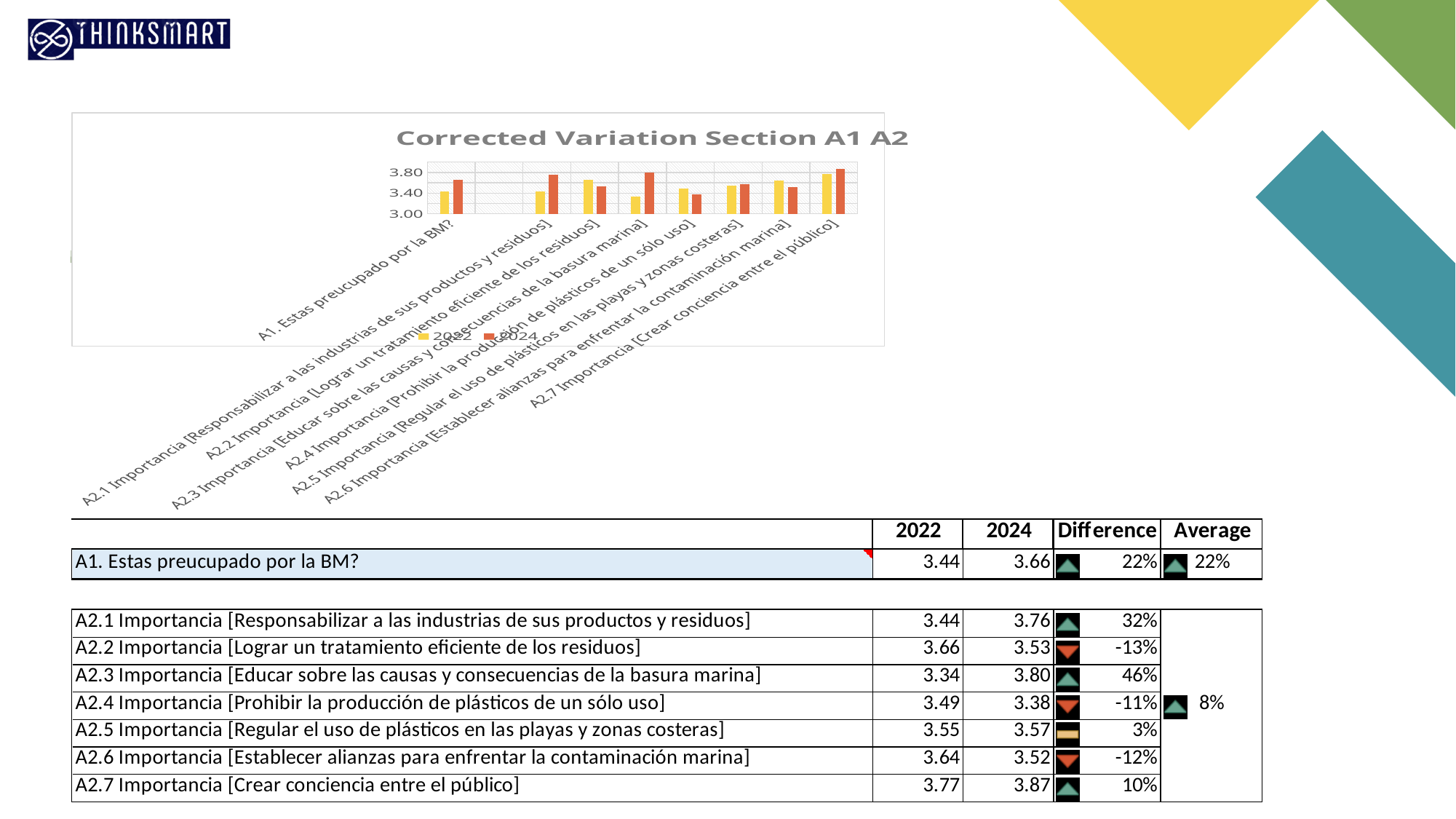
Which category has the lowest 2022 value? A2.3 Importancia [Educar sobre las causas y consecuencias de la basura marina] How many categories are plotted along the x axis of the chart? 8 Which category has the highest 2024 value? A2.7 Importancia [Crear conciencia entre el público] Is the 2024 value for A2.7 Importancia [Crear conciencia entre el público] greater or less than 3.80? greater Which series is shown in yellow in the chart? 2022 What kind of chart is shown on the slide? bar chart What is the 2024 value for A2.3 Importancia [Educar sobre las causas y consecuencias de la basura marina]? 3.80 What is the 2022 value for A1. Estas preucupado por la BM? 3.44 What is the title of the chart? Corrected Variation Section A1 A2 What is the difference between the 2024 and 2022 values for A2.3 Importancia [Educar sobre las causas y consecuencias de la basura marina]? 0.46 How many series does the chart legend list? 2 For A2.2 Importancia [Lograr un tratamiento eficiente de los residuos], which is larger, the 2022 value or the 2024 value? 2022